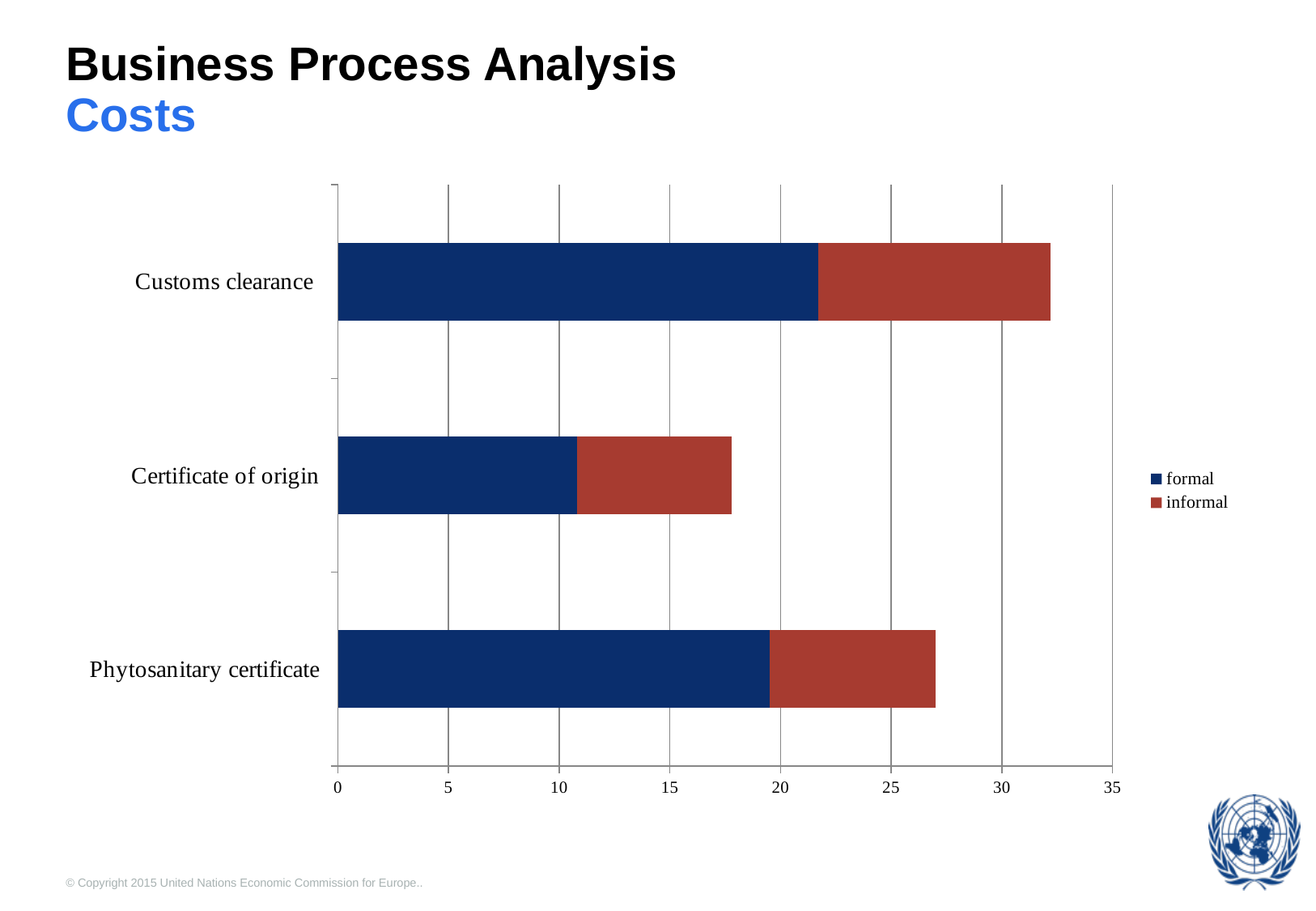
How many categories are plotted on the chart? 3 Is the total value for Certificate of origin greater or less than 20? less Is the formal value for Customs clearance greater or less than 20? greater Which is larger, the formal value for Customs clearance or the formal value for Certificate of origin? Customs clearance How many series does the legend list? 2 Which category has the longest total bar? Customs clearance Is the total value for Customs clearance greater or less than 30? greater Which category has the shortest total bar? Certificate of origin Which category has the largest informal value? Customs clearance What are the two series named in the legend? formal and informal What kind of chart is shown on the slide? bar chart